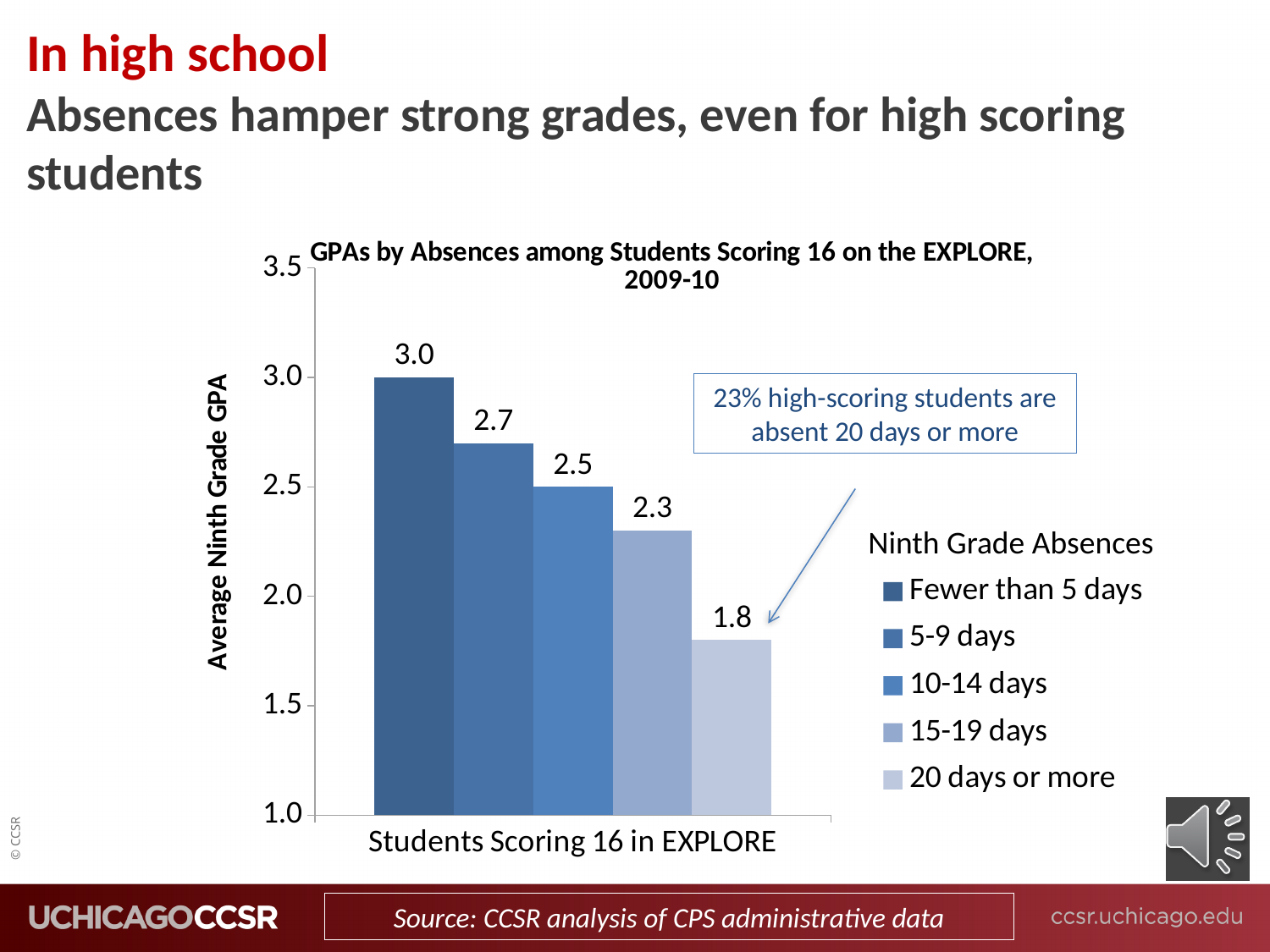
What is the difference in average GPA between students absent fewer than 5 days and those absent 20 days or more? 1.2 What is the average ninth grade GPA for students absent 20 days or more? 1.8 Which absence group has the lowest average ninth grade GPA? 20 days or more What is the average ninth grade GPA for students absent 10-14 days? 2.5 What is the title of the chart? GPAs by Absences among Students Scoring 16 on the EXPLORE, 2009-10 Do average GPAs rise or fall as the number of absence days increases? Fall According to the callout on the chart, what percentage of high-scoring students are absent 20 days or more? 23% What is the average ninth grade GPA for students with fewer than 5 days of absences? 3.0 Which group has a higher average GPA: students absent 5-9 days or students absent 15-19 days? 5-9 days How many absence groups are shown in the legend? 5 Which absence group has the highest average ninth grade GPA? Fewer than 5 days What kind of chart is shown on the slide? Bar chart